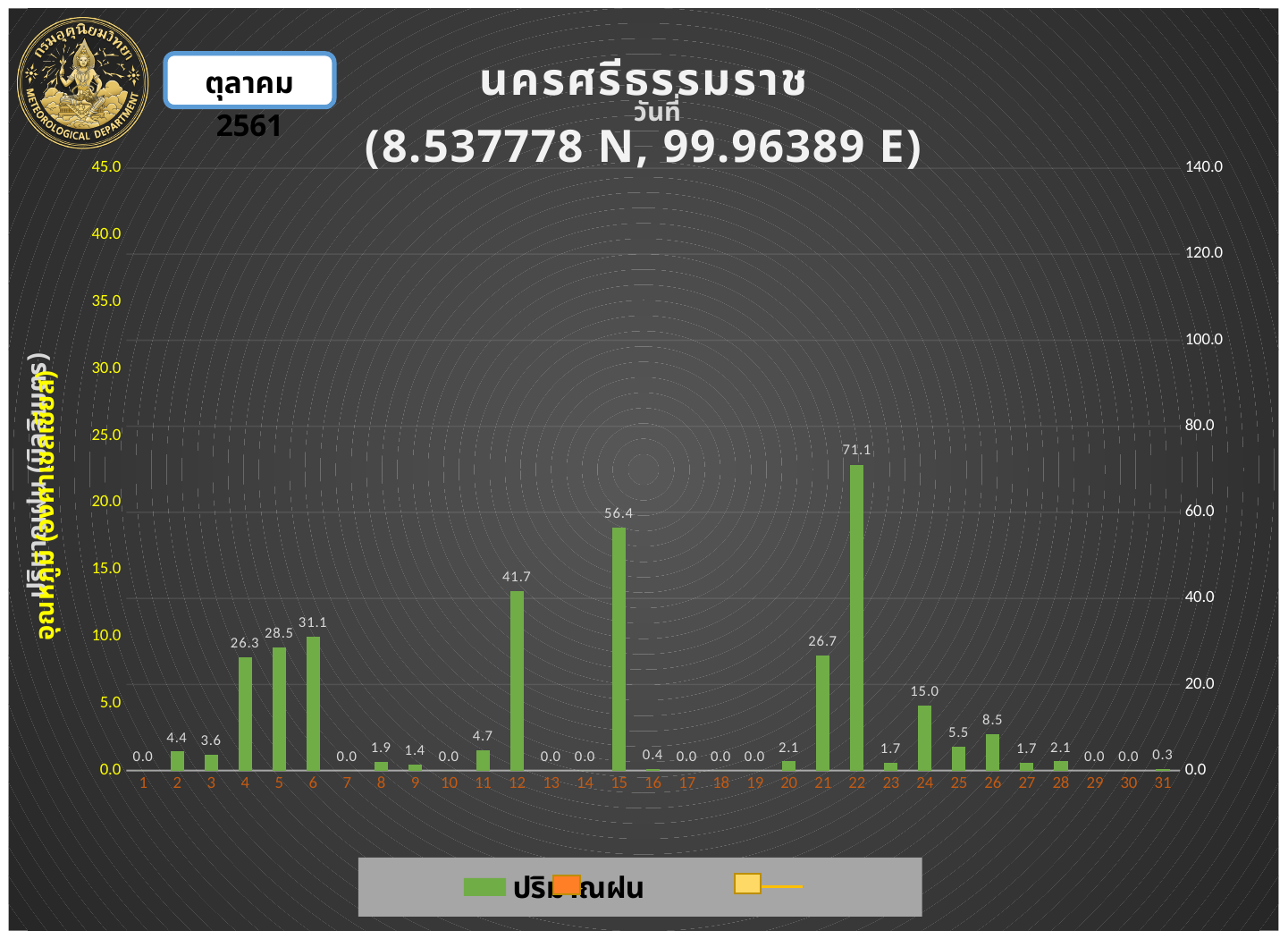
Which has a larger rainfall value, day 26 or day 25? day 26 What is the rainfall value (ปริมาณฝน) for day 22? 71.1 Which has a larger rainfall value, day 21 or day 5? day 5 What is the station name shown in the chart title? นครศรีธรรมราช What is the rainfall value for day 12? 41.7 What is the difference between the rainfall values for day 6 and day 4? 4.8 What kind of chart is shown on the slide? bar chart What is the difference between the rainfall values for day 22 and day 15? 14.7 How many days are shown on the x axis? 31 Which day has the highest rainfall value? 22 What is the rainfall value for day 15? 56.4 What is the rainfall value for day 24? 15.0